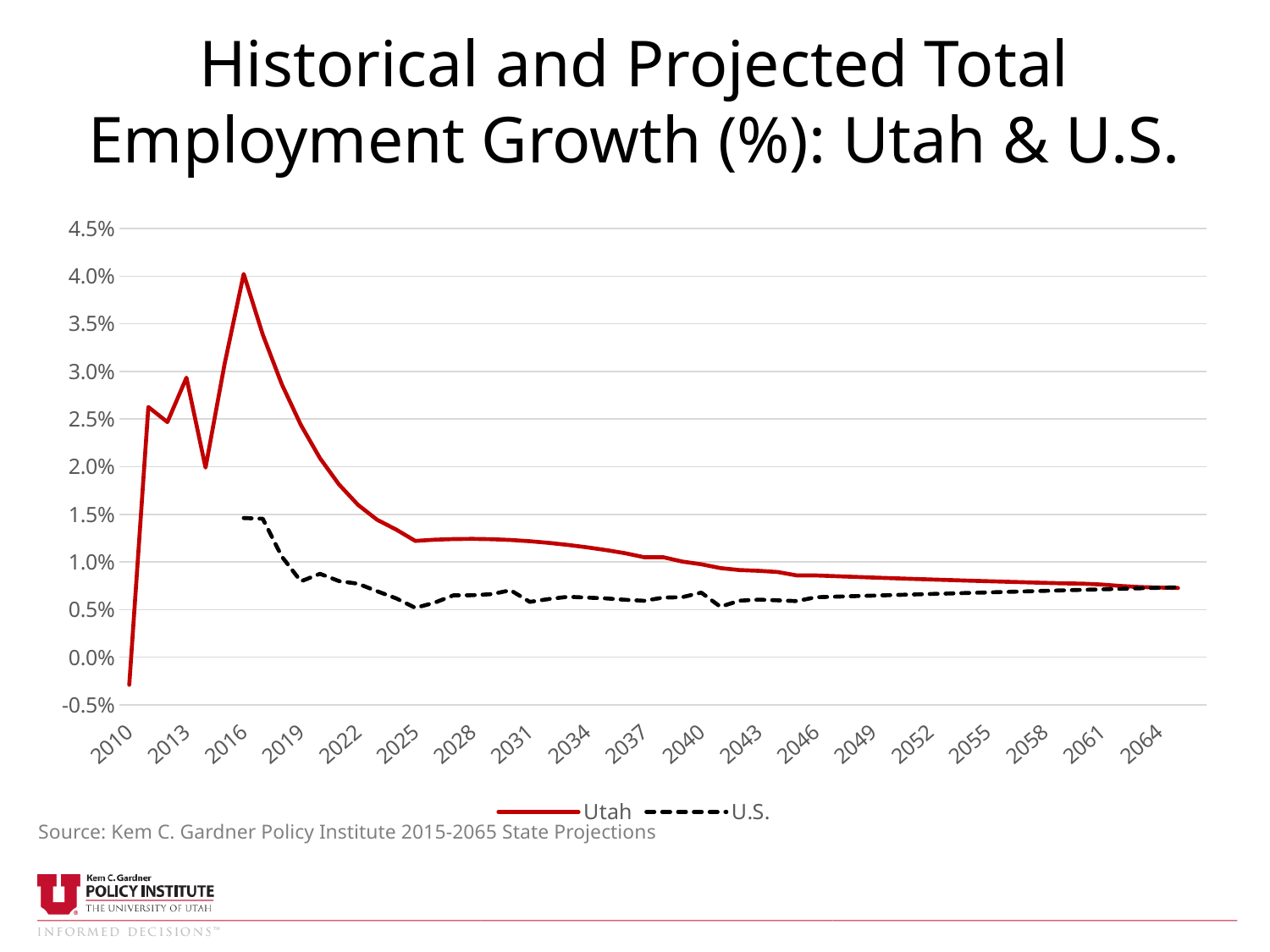
What kind of chart is shown on the slide? Line chart Is the U.S. value in 2025 greater or less than 1.0%? less Does the Utah series rise or fall from 2016 to 2064? Fall Which series reaches the highest value on the chart? Utah In which year does the Utah series reach its peak? 2016 How many series does the legend list? 2 Is the Utah value in 2010 greater or less than 0.0%? less What are the two series named in the legend? Utah and U.S. Is the Utah value in 2016 greater or less than 3.5%? greater In 2040, which series has the larger value, Utah or U.S.? Utah In which year is the Utah series at its lowest value? 2010 Which series is drawn as a dashed line? U.S.